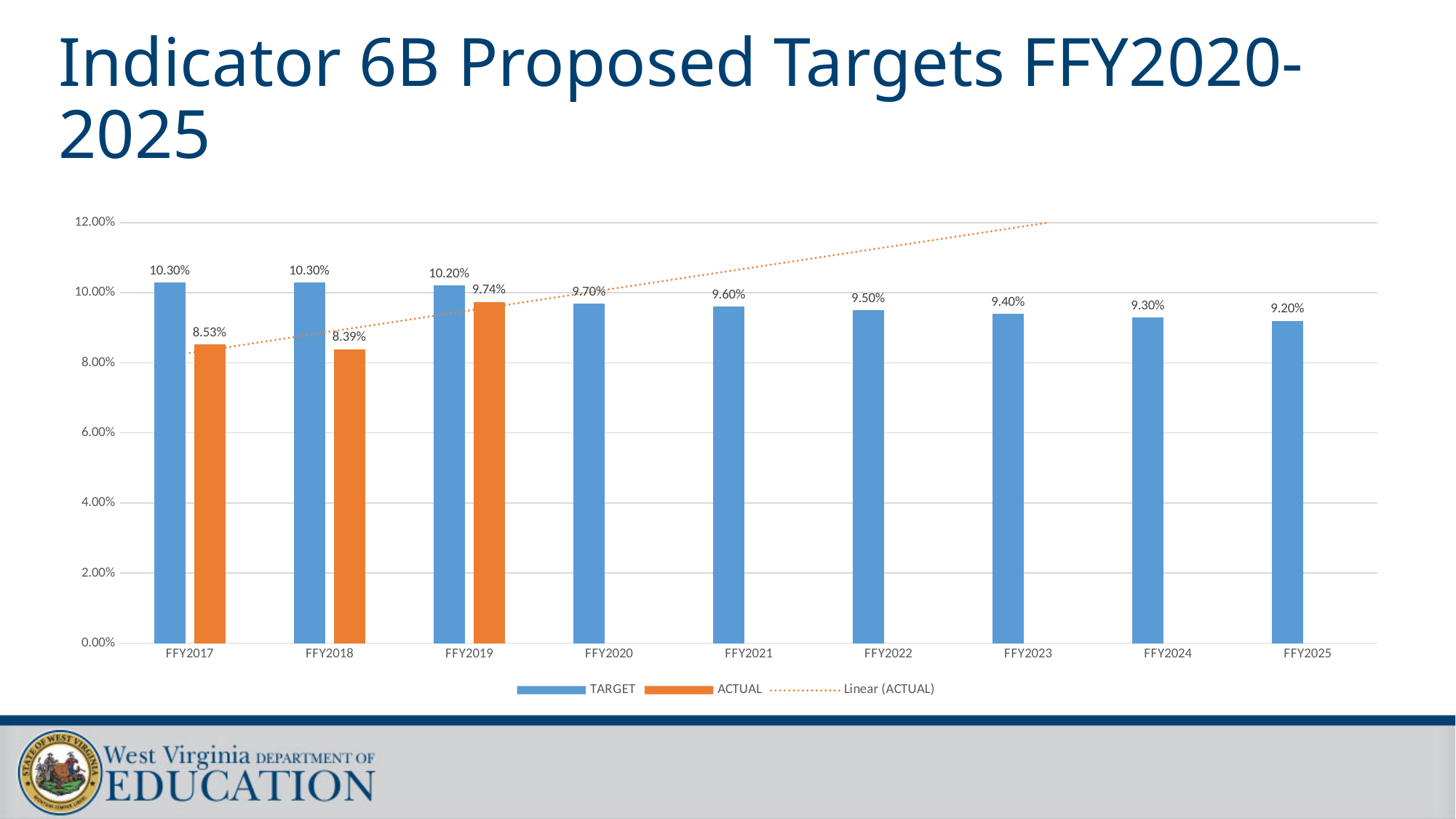
What is the difference between the TARGET and ACTUAL values for FFY2017? 1.77% How many years are shown on the x axis? 9 What is the ACTUAL value for FFY2018? 8.39% What kind of chart is shown on the slide? Bar chart What is the ACTUAL value for FFY2019? 9.74% Which year has the lowest TARGET value? FFY2025 Which is larger for FFY2019, the TARGET or the ACTUAL value? TARGET Do the TARGET values rise or fall from FFY2020 to FFY2025? Fall What is the TARGET value for FFY2025? 9.20% Which year has the highest ACTUAL value? FFY2019 How many entries does the legend list? 3 What is the TARGET value for FFY2020? 9.70%